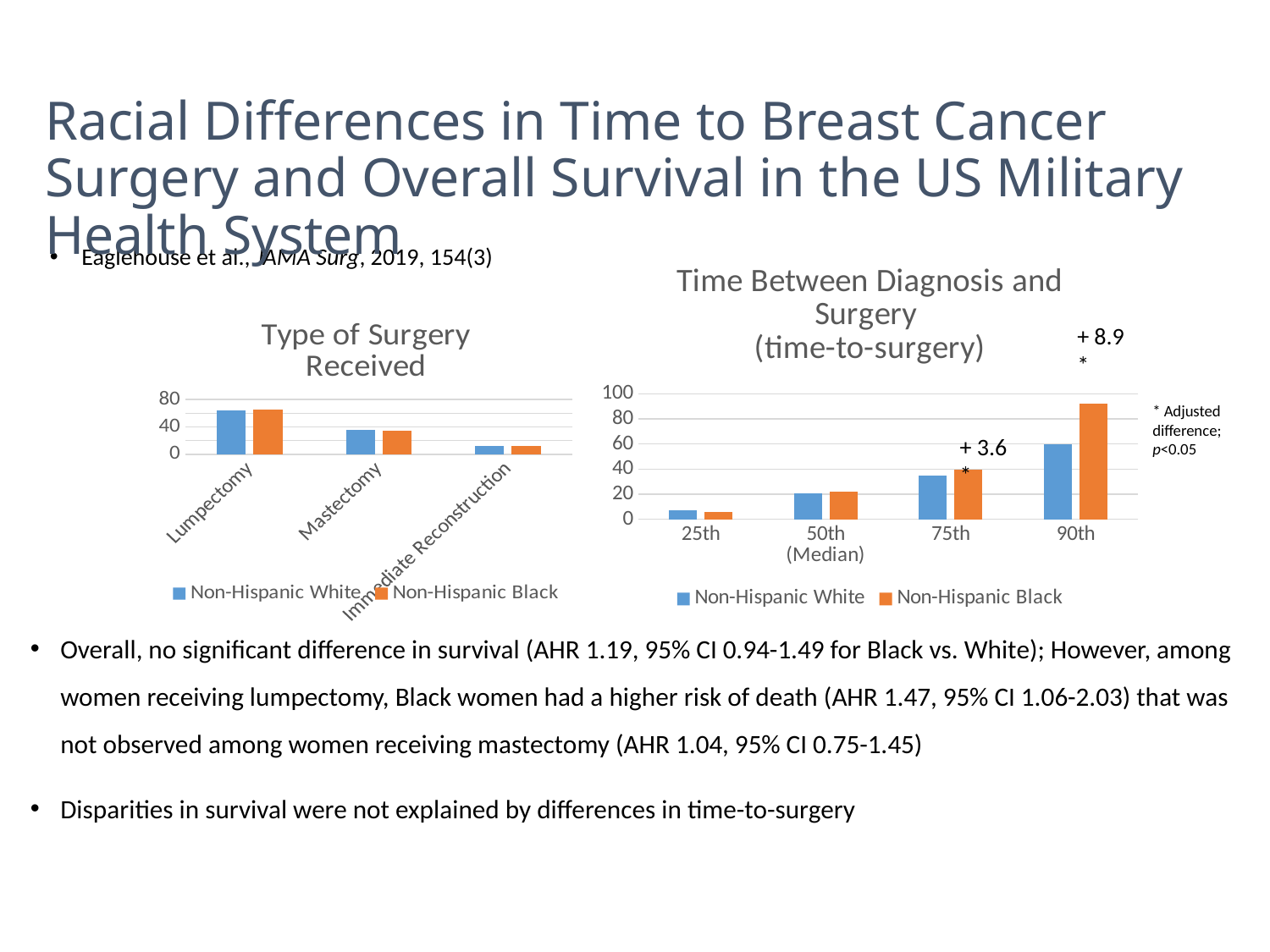
In the "Time Between Diagnosis and Surgery" chart, is the Non-Hispanic Black value at the 90th percentile greater or less than 80? greater How many percentile categories are shown on the x axis of the "Time Between Diagnosis and Surgery" chart? 4 How many surgery types are shown on the x axis of the "Type of Surgery Received" chart? 3 What kind of chart is the "Type of Surgery Received" chart? bar chart In the "Type of Surgery Received" chart, which surgery type has the lowest values? Immediate Reconstruction In the "Type of Surgery Received" chart, is the Non-Hispanic White value for Lumpectomy greater or less than 40? greater In the "Time Between Diagnosis and Surgery" chart, do the values rise or fall from the 25th to the 90th percentile? rise In the "Type of Surgery Received" chart, which surgery type has the highest values? Lumpectomy In the "Type of Surgery Received" chart, is the Non-Hispanic Black value for Immediate Reconstruction greater or less than 40? less How many series does the legend of the "Type of Surgery Received" chart list? 2 In the "Time Between Diagnosis and Surgery" chart, which category has the highest Non-Hispanic Black value? 90th In the "Time Between Diagnosis and Surgery" chart, at the 90th percentile, which group has the larger value, Non-Hispanic White or Non-Hispanic Black? Non-Hispanic Black